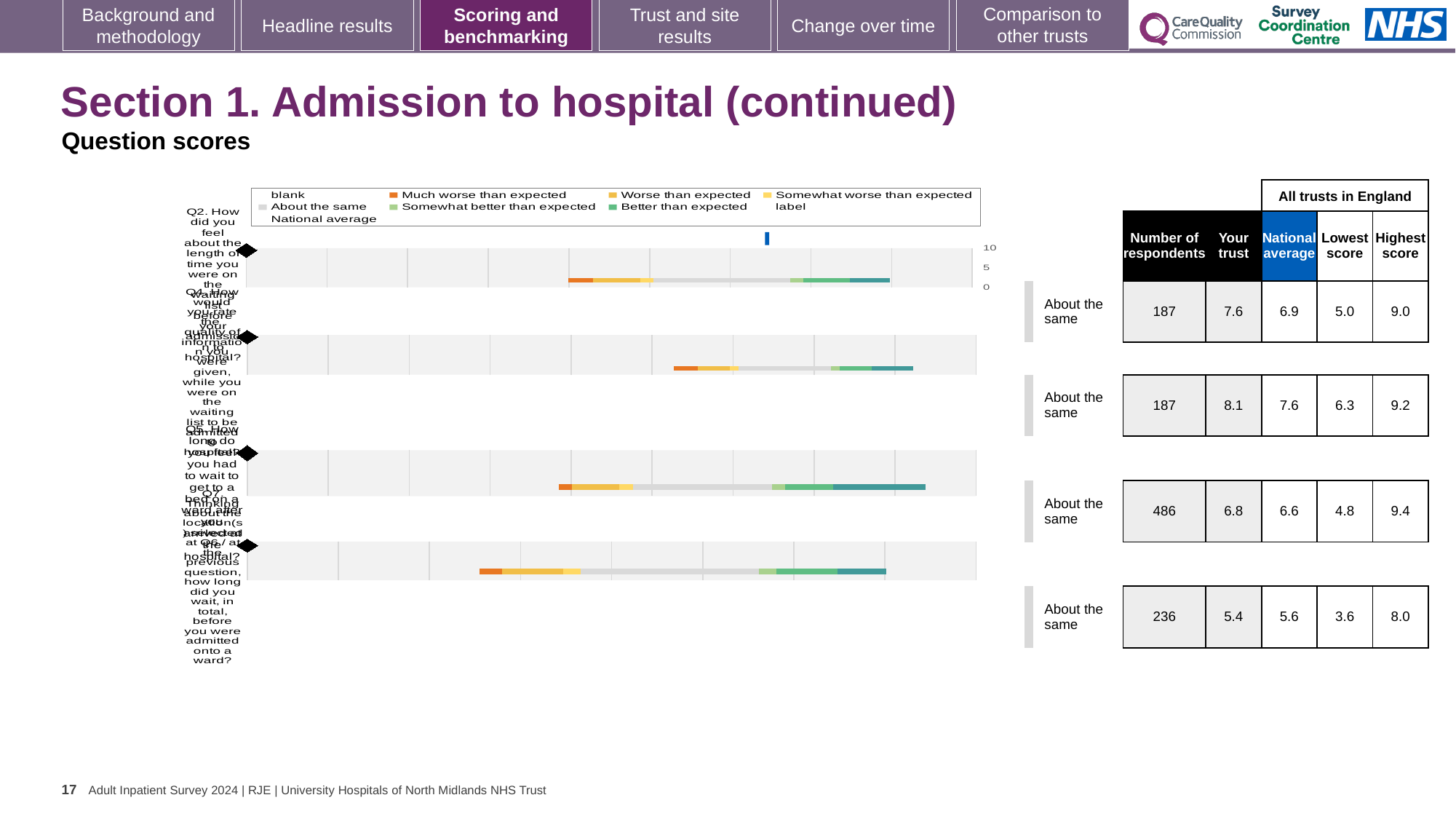
What colour does the legend use for 'Much worse than expected'? orange What is the highest value shown on the chart's score axis? 10 In the fourth row of the table, which is larger: the 'Your trust' score or the national average? National average In the table, what is the national average in the fourth row? 5.6 In the table, what is the number of respondents in the third row? 486 What benchmark label is shown for every question row on the slide? About the same What kind of chart is shown on the slide? bar chart In the second row of the table, what is the difference between the 'Your trust' score and the national average? 0.5 How many question rows (bars) are plotted in the chart? 4 Which row of the table has the highest 'Your trust' score? the second row (8.1) Which row of the table has the lowest 'Your trust' score? the fourth row (5.4) In the table, what is the 'Your trust' score in the first row? 7.6